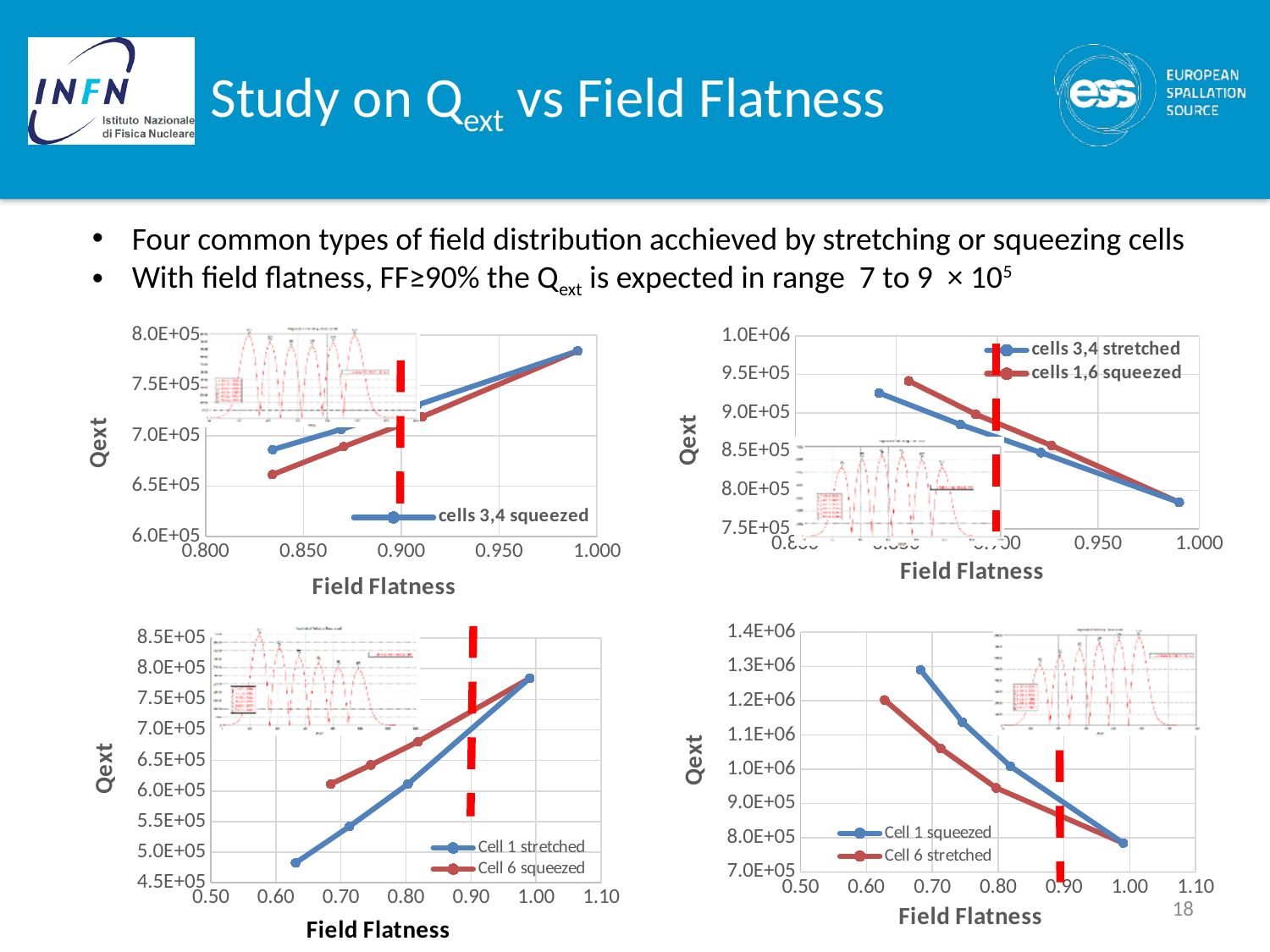
What kind of chart is the bottom-left chart (legend 'Cell 1 stretched' / 'Cell 6 squeezed')? Line chart How many series does the legend of the top-right chart list? 2 In the bottom-right chart, does Qext rise or fall as Field Flatness increases? Fall In the bottom-right chart, which series reaches the higher maximum Qext, 'Cell 1 squeezed' or 'Cell 6 stretched'? Cell 1 squeezed What are the two legend entries of the bottom-right chart? Cell 1 squeezed and Cell 6 stretched In the top-right chart, is the Qext value of 'cells 3,4 stretched' at Field Flatness 1.000 greater or less than 8.0E+05? less In the bottom-left chart, does Qext rise or fall as Field Flatness increases? Rise In the top-right chart, does Qext rise or fall as Field Flatness increases? Fall In the bottom-left chart, is the lowest Qext value of the 'Cell 1 stretched' series greater or less than 5.0E+05? less How many data points does the 'Cell 1 stretched' series have in the bottom-left chart? 4 What is the y-axis title of the bottom-left chart? Qext In the bottom-right chart, is the highest Qext value of the 'Cell 1 squeezed' series greater or less than 1.2E+06? greater